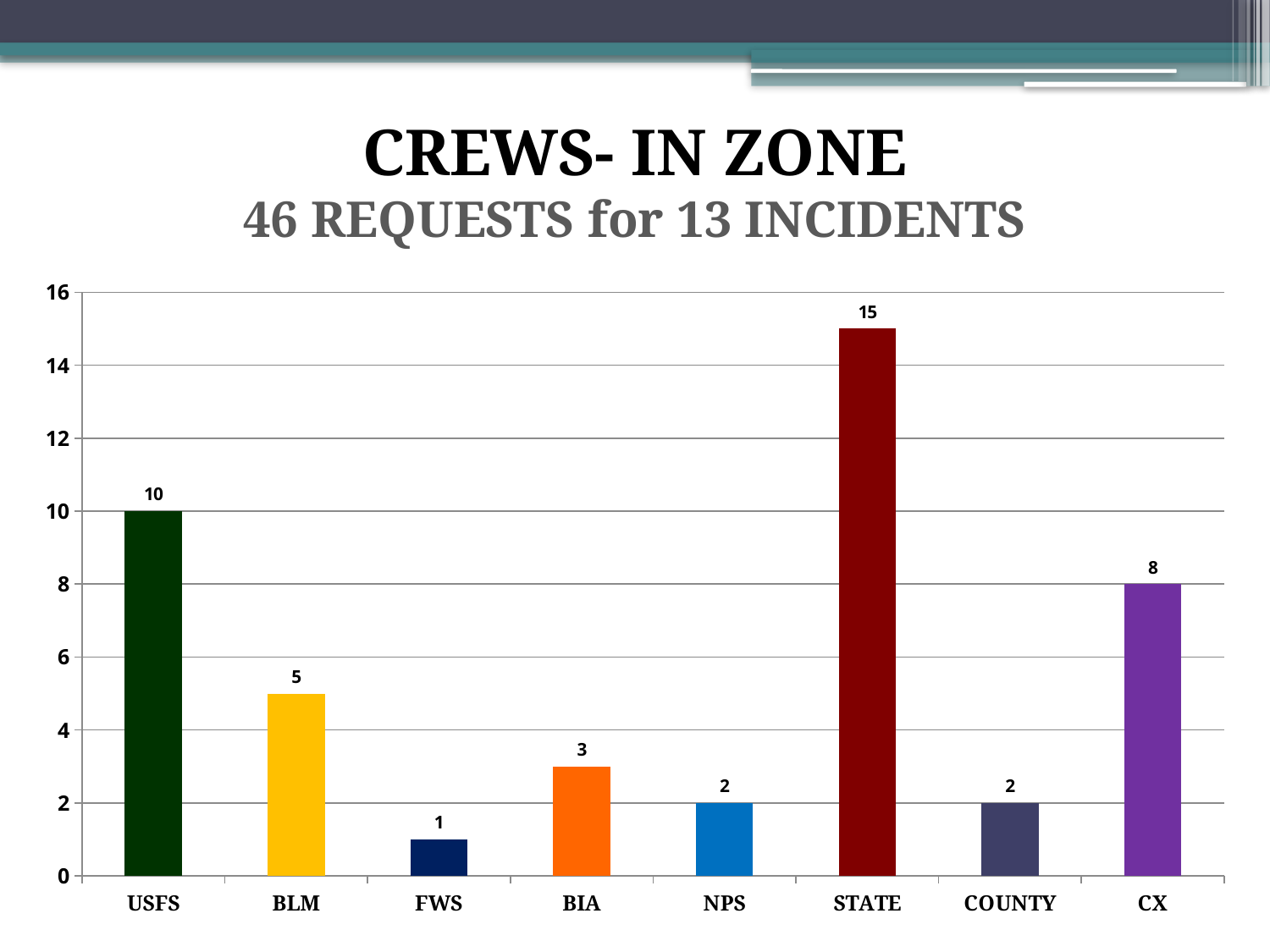
What is the value for BLM? 5 Which category has the highest value? STATE What is the title of the chart on the slide? CREWS- IN ZONE What is the value for STATE? 15 Which is larger, the value for BLM or the value for CX? CX What is the difference between the values for STATE and USFS? 5 What kind of chart is shown on the slide? bar chart How many categories are shown on the x axis? 8 What is the value for CX? 8 What is the difference between the values for CX and BIA? 5 Which category has the lowest value? FWS What is the value for USFS? 10